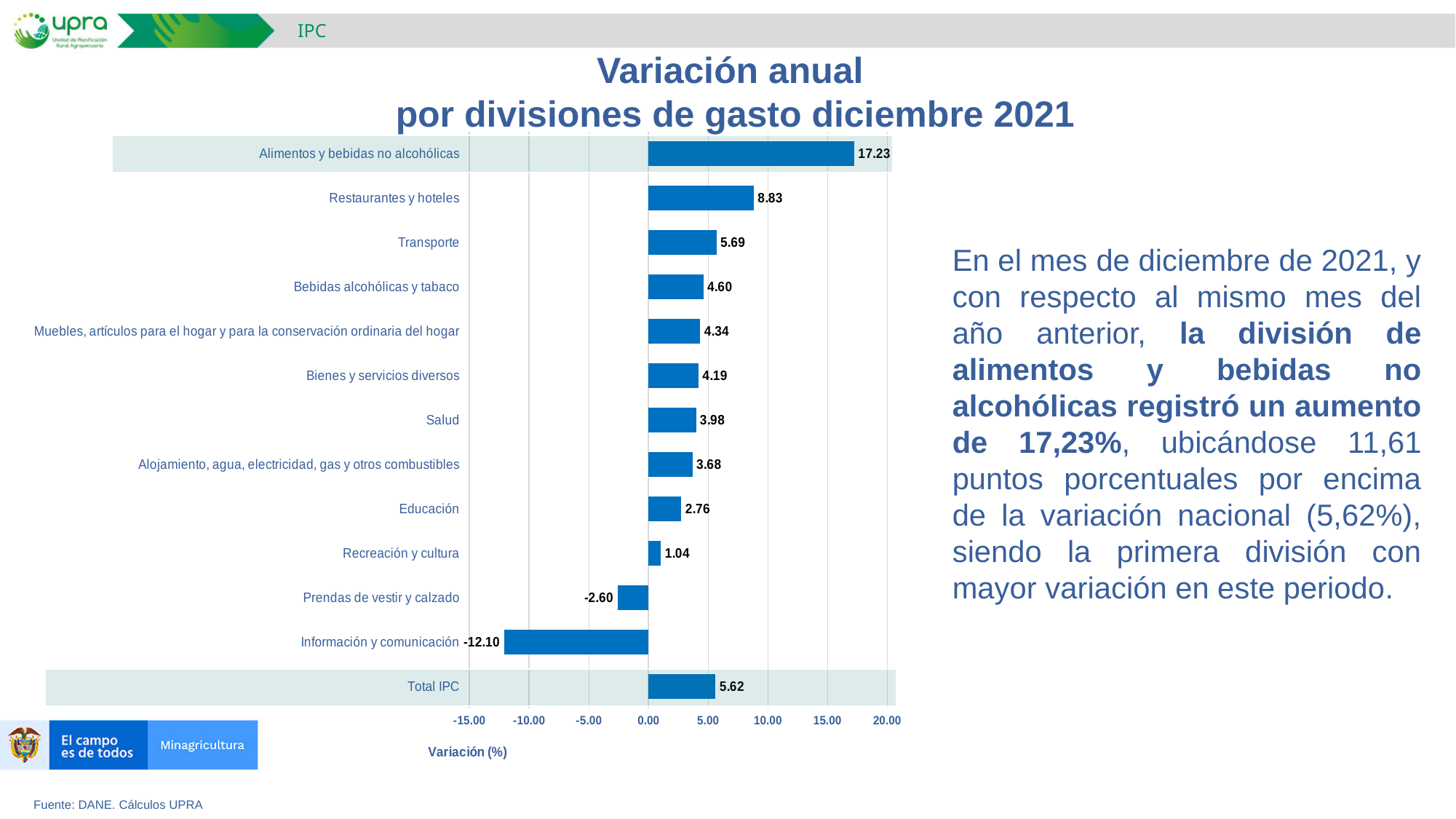
What is the value for Total IPC? 5.62 Which is larger, the value for Transporte or the value for Restaurantes y hoteles? Restaurantes y hoteles What is the difference between the values for Alimentos y bebidas no alcohólicas and Total IPC? 11.61 Is the value for Prendas de vestir y calzado greater or less than 0.00? less What is the value for Información y comunicación? -12.10 What is the value for Alimentos y bebidas no alcohólicas? 17.23 How many categories are shown in the chart? 13 Which category has the lowest value? Información y comunicación Which category has the highest value? Alimentos y bebidas no alcohólicas What kind of chart is shown on the slide? bar chart What is the label of the horizontal axis? Variación (%) What is the value for Educación? 2.76